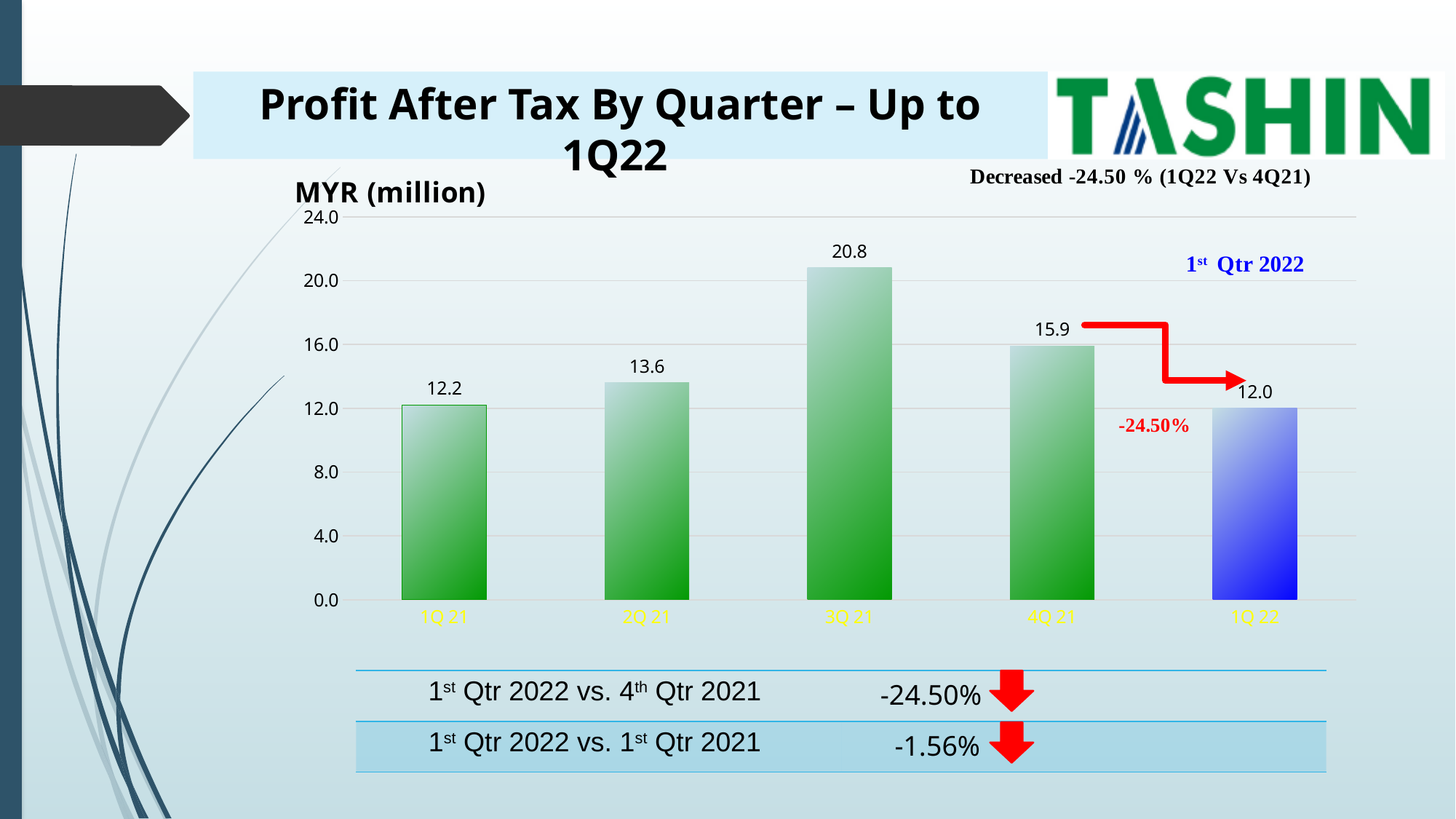
Which quarter has the highest profit after tax? 3Q 21 Which quarter has a higher profit after tax, 1Q 21 or 4Q 21? 4Q 21 What type of chart is shown on the slide? Bar chart What is the difference in profit after tax between 3Q 21 and 2Q 21? 7.2 What is the profit after tax for 3Q 21? 20.8 What percentage change is shown for 1st Qtr 2022 vs. 1st Qtr 2021? -1.56% What is the unit shown on the chart's axis label? MYR (million) What is the difference in profit after tax between 4Q 21 and 1Q 22? 3.9 What is the profit after tax for 2Q 21? 13.6 How many quarters are shown in the chart? 5 What is the profit after tax for 1Q 22? 12.0 Which quarter has the lowest profit after tax? 1Q 22